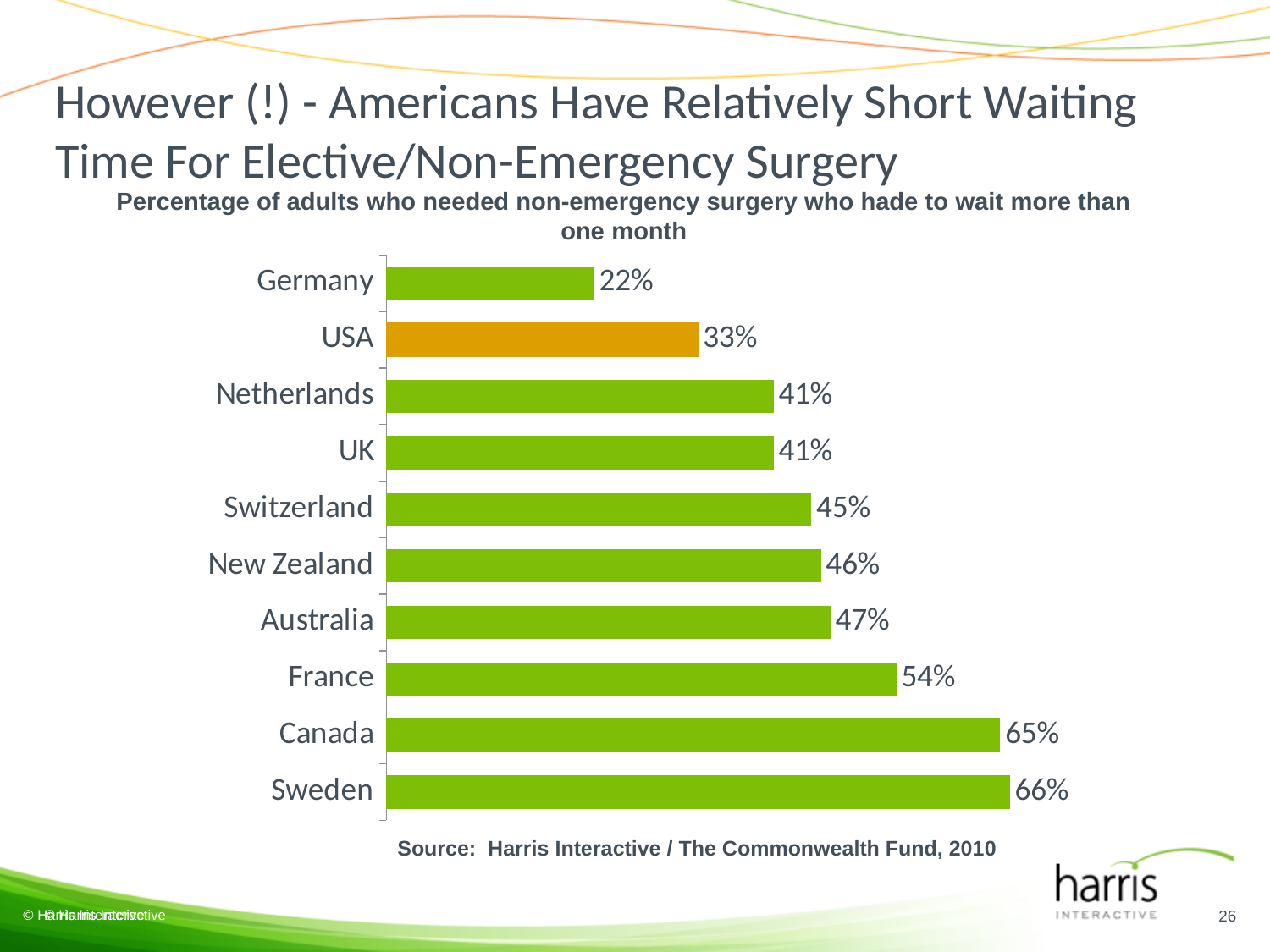
How many countries are shown in the chart? 10 What is the value shown for Switzerland? 45% Which has a higher value, Australia or New Zealand? Australia Which country's bar is coloured differently (orange) from the others? USA Which country has the highest percentage of adults who had to wait more than one month? Sweden What percentage of adults in the USA had to wait more than one month for non-emergency surgery? 33% What is the difference between the values for France and the USA? 21 percentage points Which country has the lowest percentage of adults who had to wait more than one month? Germany What is the value shown for Canada? 65% What kind of chart is shown on the slide? Bar chart What is the difference between the values for Sweden and Germany? 44 percentage points Which has a higher value, the USA or the Netherlands? Netherlands